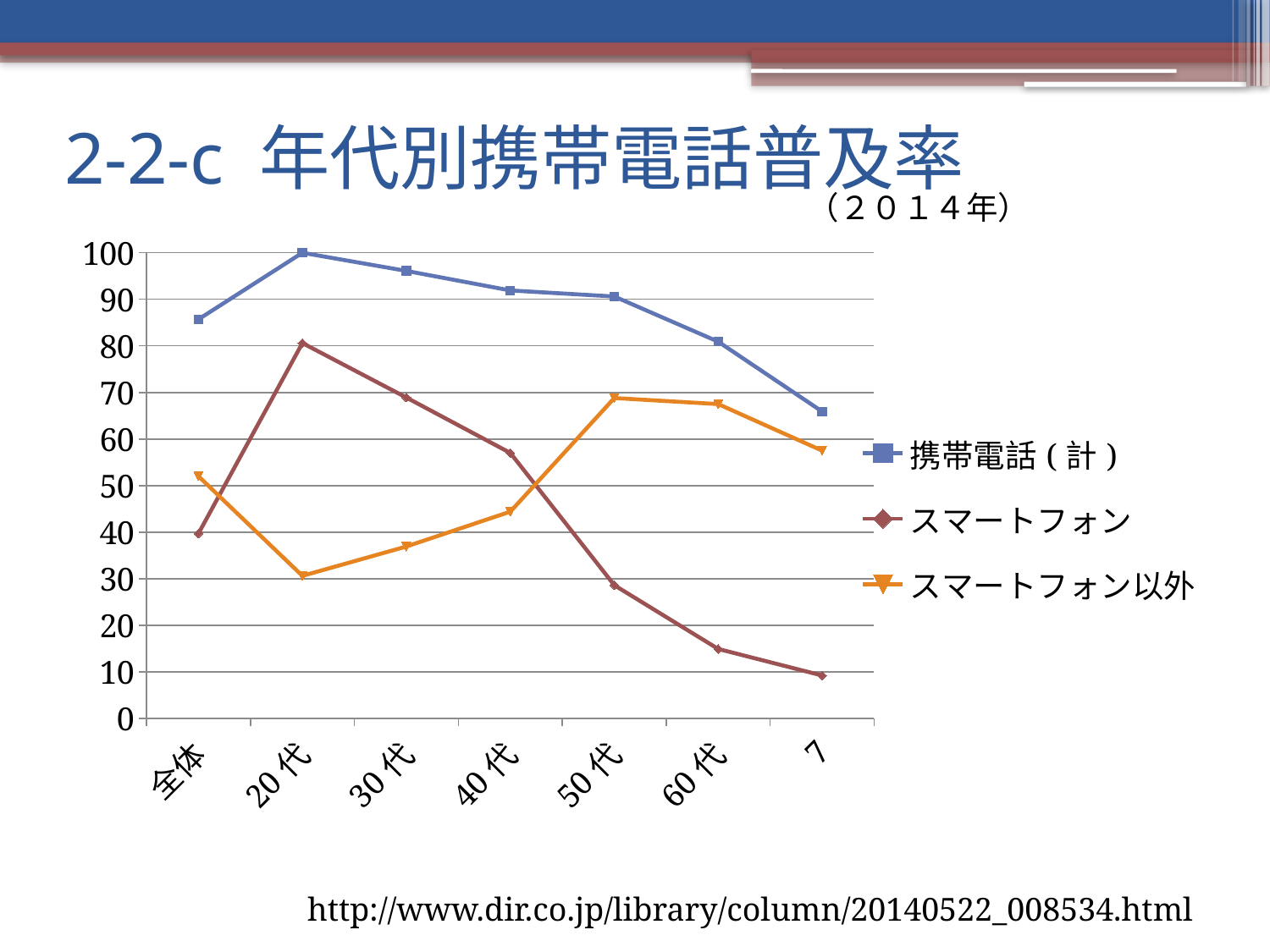
How many series does the legend list? 3 What kind of chart is shown on the slide? line chart Which category has the highest value for スマートフォン? 20代 At 40代, which is larger: スマートフォン or スマートフォン以外? スマートフォン Which category has the highest value for 携帯電話(計)? 20代 Is the value for スマートフォン at 50代 greater or less than 40? less Which category has the lowest value for スマートフォン以外? 20代 How many categories are plotted along the x axis? 7 Is the value for スマートフォン以外 at 全体 greater or less than 40? greater At 50代, which is larger: スマートフォン or スマートフォン以外? スマートフォン以外 Is the value for 携帯電話(計) at 60代 greater or less than 70? greater From 20代 to 60代, does the スマートフォン line rise or fall? fall